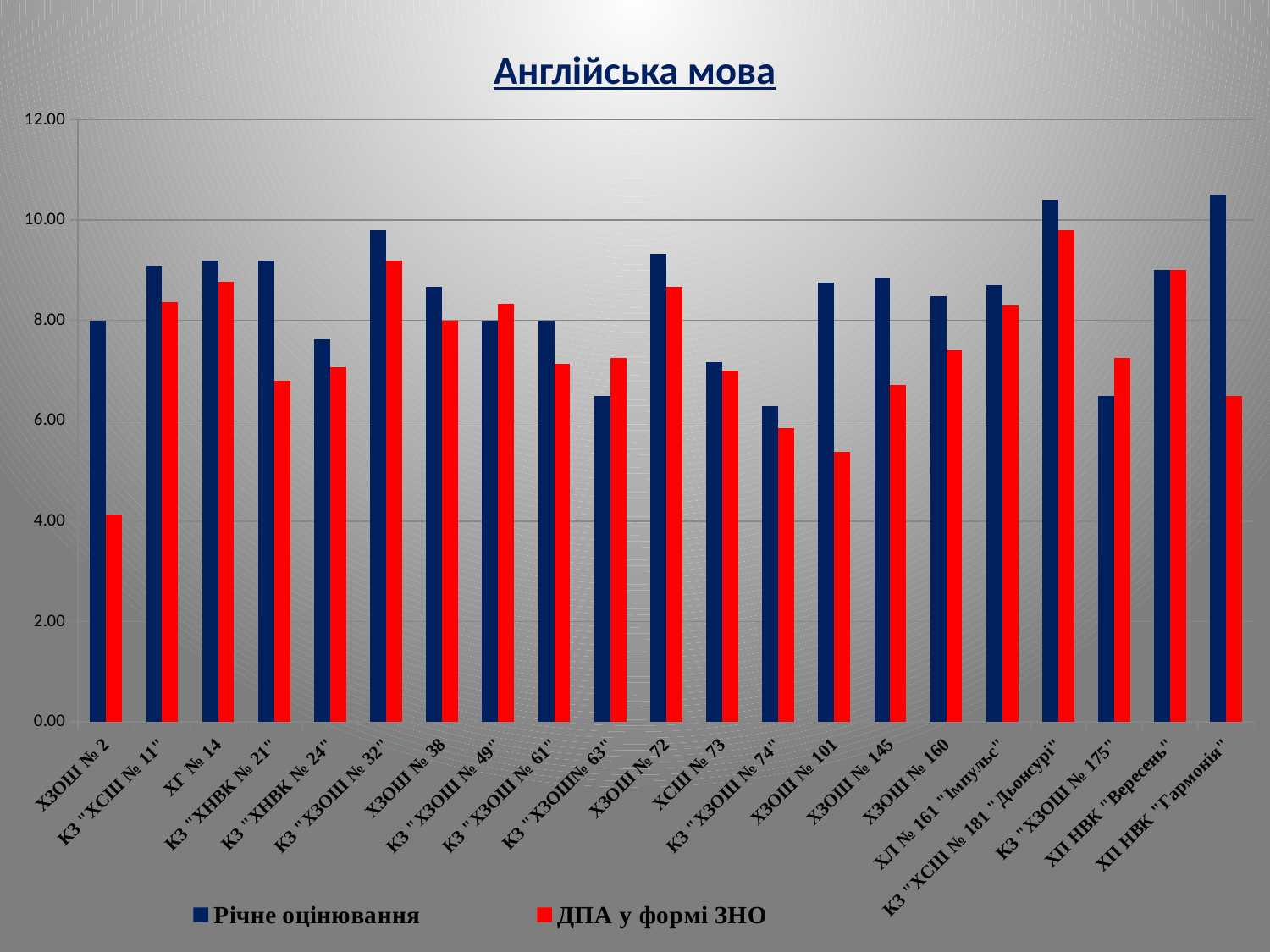
What kind of chart is shown on the slide? bar chart For ХЗОШ № 2, which is larger: Річне оцінювання or ДПА у формі ЗНО? Річне оцінювання Is the ДПА у формі ЗНО value for ХЗОШ № 101 greater or less than 6.00? less How many series does the legend list? 2 Is the ДПА у формі ЗНО value for ХЗОШ № 2 greater or less than 6.00? less Which series is shown in red? ДПА у формі ЗНО How many schools (categories) are shown on the x axis? 21 Which school has the lowest value for ДПА у формі ЗНО? ХЗОШ № 2 For КЗ "ХЗОШ № 175", which is larger: Річне оцінювання or ДПА у формі ЗНО? ДПА у формі ЗНО Is the Річне оцінювання value for ХП НВК "Гармонія" greater or less than 10.00? greater Which school has the highest value for ДПА у формі ЗНО? КЗ "ХСШ № 181 "Дьонсурі" What is the title of the chart? Англійська мова